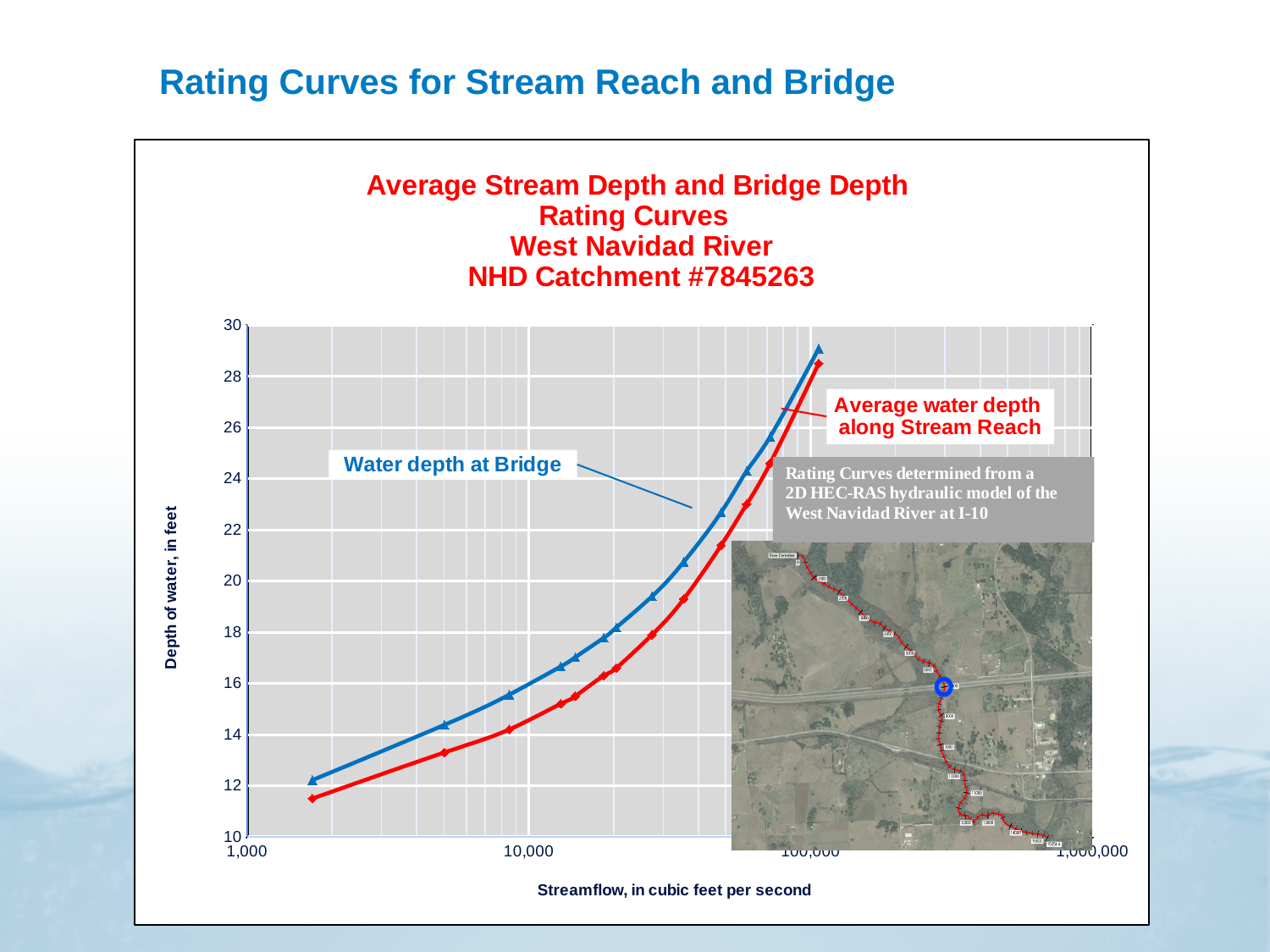
How many data series are plotted on the chart? 2 Which series is plotted in red? Average water depth along Stream Reach Which series reaches the highest depth of water on the chart? Water depth at Bridge Is the highest value of the Water depth at Bridge series greater or less than 28 feet? greater What is the label of the x axis of the chart? Streamflow, in cubic feet per second Which series is plotted in blue? Water depth at Bridge Which series has the lowest depth of water on the chart? Average water depth along Stream Reach Which series shows the greater water depth at any given streamflow, Water depth at Bridge or Average water depth along Stream Reach? Water depth at Bridge Is the lowest value of the Average water depth along Stream Reach series greater or less than 14 feet? less Do the water depth values rise or fall as streamflow increases along the x axis? Rise What kind of chart is shown on the slide? Line chart Is the lowest value of the Water depth at Bridge series greater or less than 14 feet? less